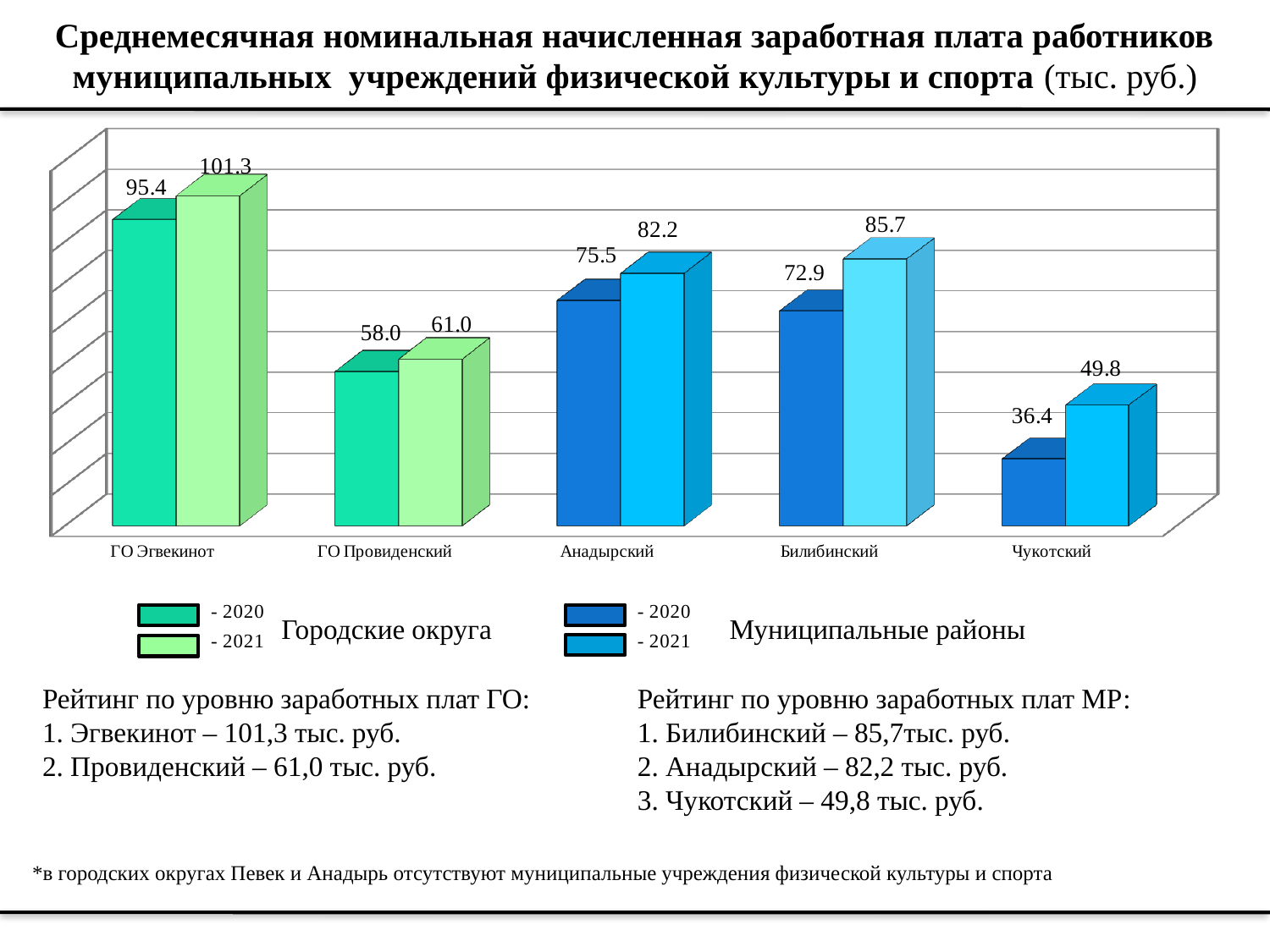
Which is larger, the 2021 value for Анадырский or the 2021 value for Билибинский? Билибинский What is the 2020 value for Билибинский? 72.9 What is the difference between the 2021 values for Анадырский and Чукотский? 32.4 What is the difference between the 2021 and 2020 values for Билибинский? 12.8 Which category has the highest 2021 value? ГО Эгвекинот What type of chart is shown on the slide? Bar chart Which category has the lowest 2020 value? Чукотский What is the 2021 value for Чукотский? 49.8 What is the 2021 value for ГО Эгвекинот? 101.3 Which two years are compared in the chart legend? 2020 and 2021 What is the 2020 value for ГО Провиденский? 58.0 How many categories are shown on the x axis? 5